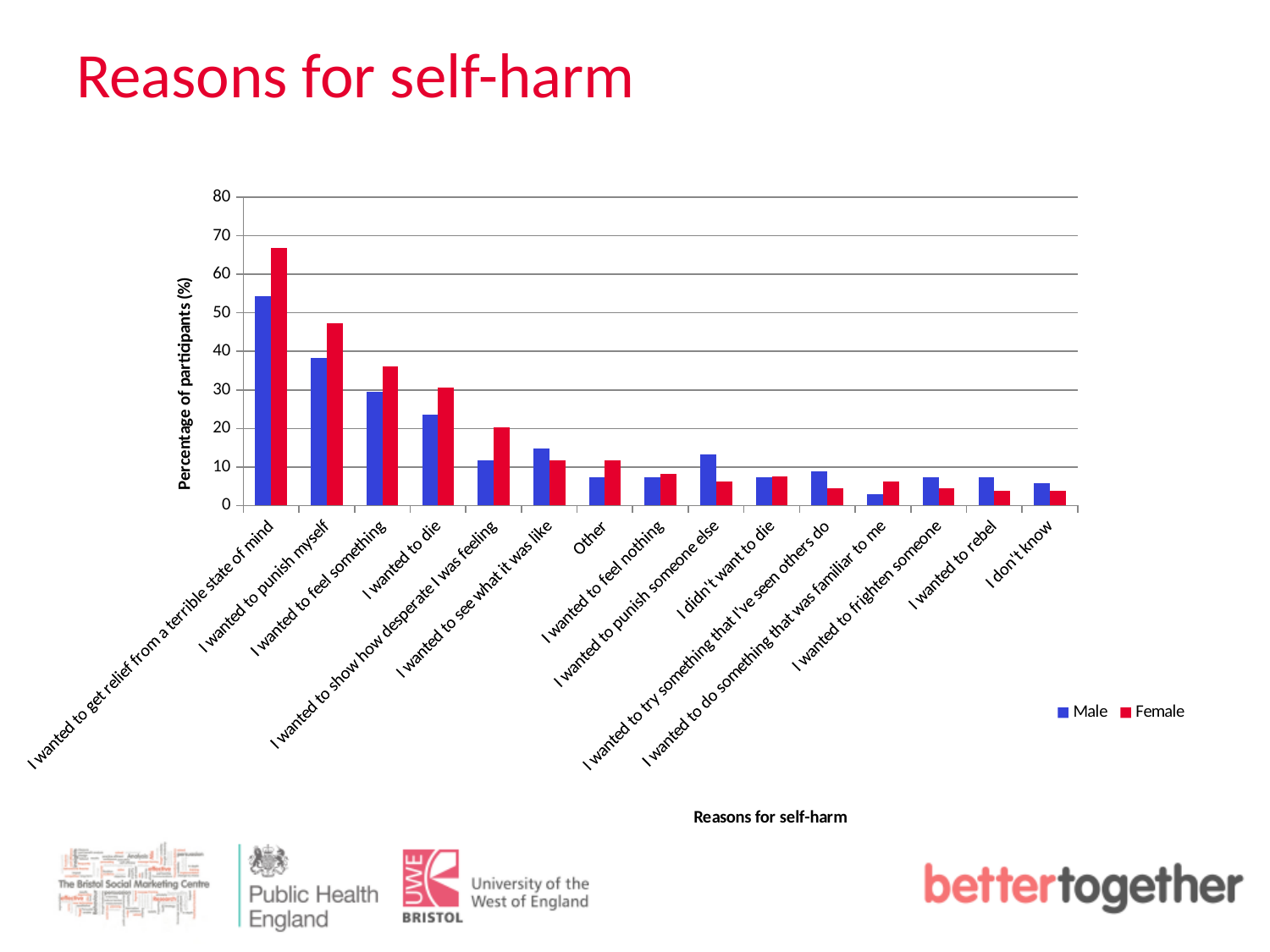
For 'I wanted to die', which is larger, the Male or the Female value? Female What kind of chart is shown on the slide? Bar chart Which reason has the highest Female value? I wanted to get relief from a terrible state of mind How many series does the legend list? 2 What is the title of the y axis? Percentage of participants (%) For 'I wanted to punish someone else', which is larger, the Male or the Female value? Male Is the Male value for 'I wanted to punish myself' greater or less than 30? greater Which reason has the highest Male value? I wanted to get relief from a terrible state of mind Is the Female value for 'I wanted to show how desperate I was feeling' greater or less than 30? less Which reason has the lowest Male value? I wanted to do something that was familiar to me How many reasons for self-harm are shown on the x axis? 15 Is the Female value for 'I wanted to get relief from a terrible state of mind' greater or less than 60? greater